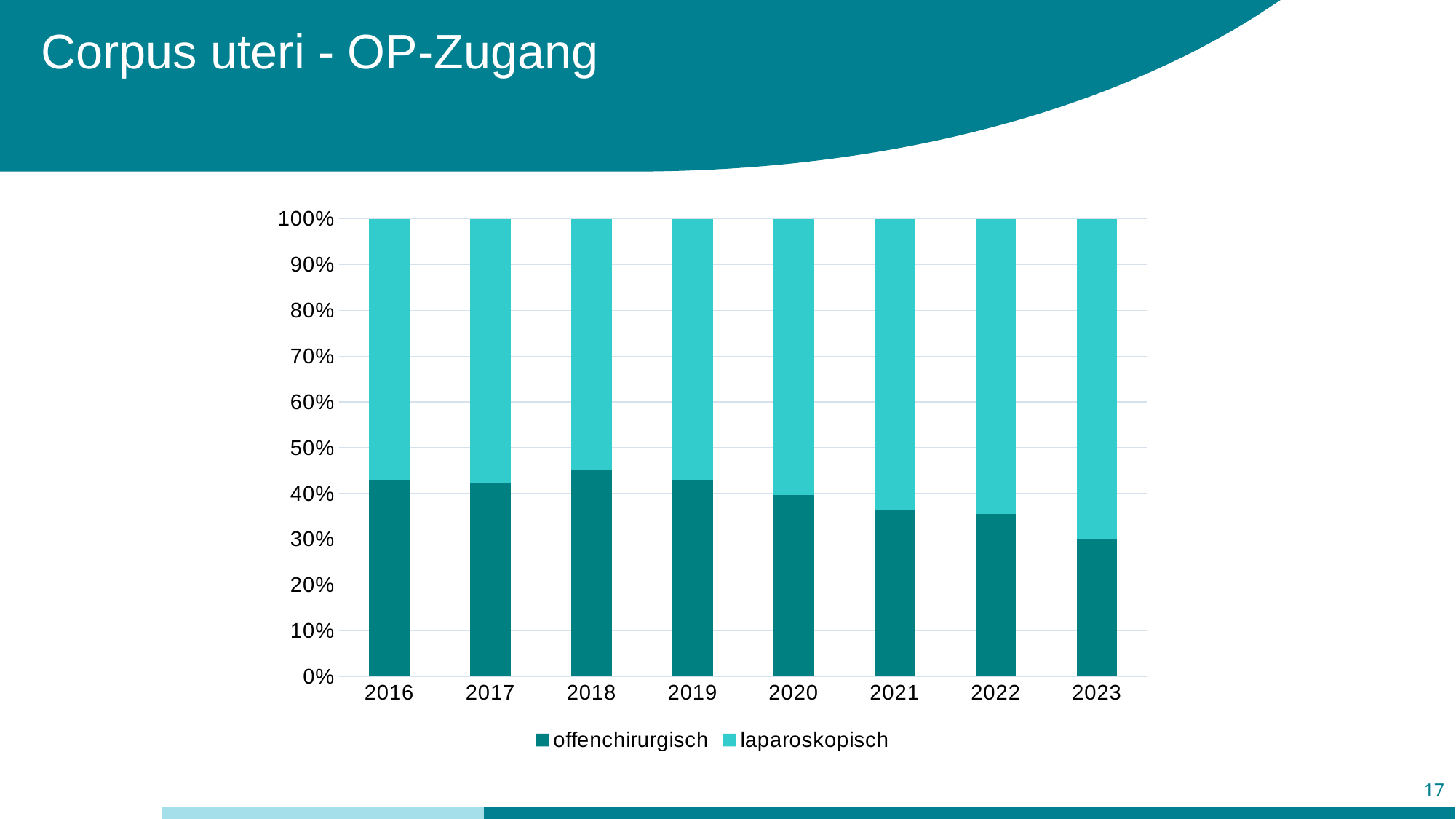
Does the offenchirurgisch share generally rise or fall from 2016 to 2023? fall Which series is shown in the darker teal colour at the bottom of each bar? offenchirurgisch In which year is the offenchirurgisch share the lowest? 2023 What is the title of the slide containing the chart? Corpus uteri - OP-Zugang How many series does the legend list? 2 How many years are shown on the x axis of the chart? 8 Is the laparoskopisch share for 2023 greater or less than 60%? greater Is the offenchirurgisch share for 2018 greater or less than 40%? greater What kind of chart is shown on the slide? Stacked bar chart Which year has the larger offenchirurgisch share, 2016 or 2023? 2016 Is the offenchirurgisch share for 2020 greater or less than 50%? less